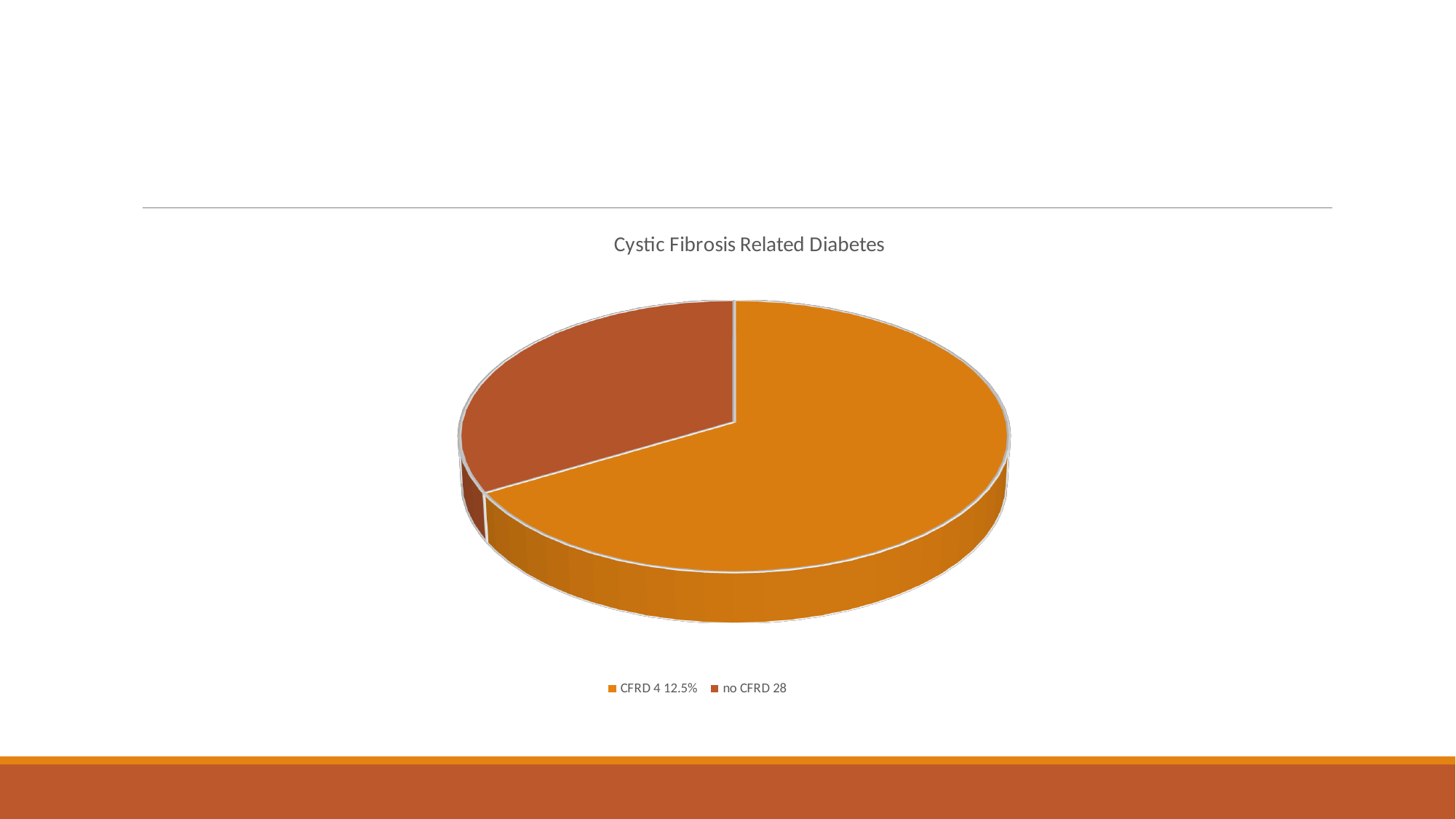
Which slice is larger, the one labelled "CFRD 4 12.5%" or the one labelled "no CFRD 28"? CFRD 4 12.5% How many entries does the legend list? 2 What is the title of the chart? Cystic Fibrosis Related Diabetes What colour is the slice labelled "no CFRD 28" in the legend? dark red-brown Which legend entry corresponds to the smallest slice of the pie? no CFRD 28 How many slices does the pie chart have? 2 What kind of chart is shown on the slide? pie chart Which legend entry corresponds to the largest slice of the pie? CFRD 4 12.5%